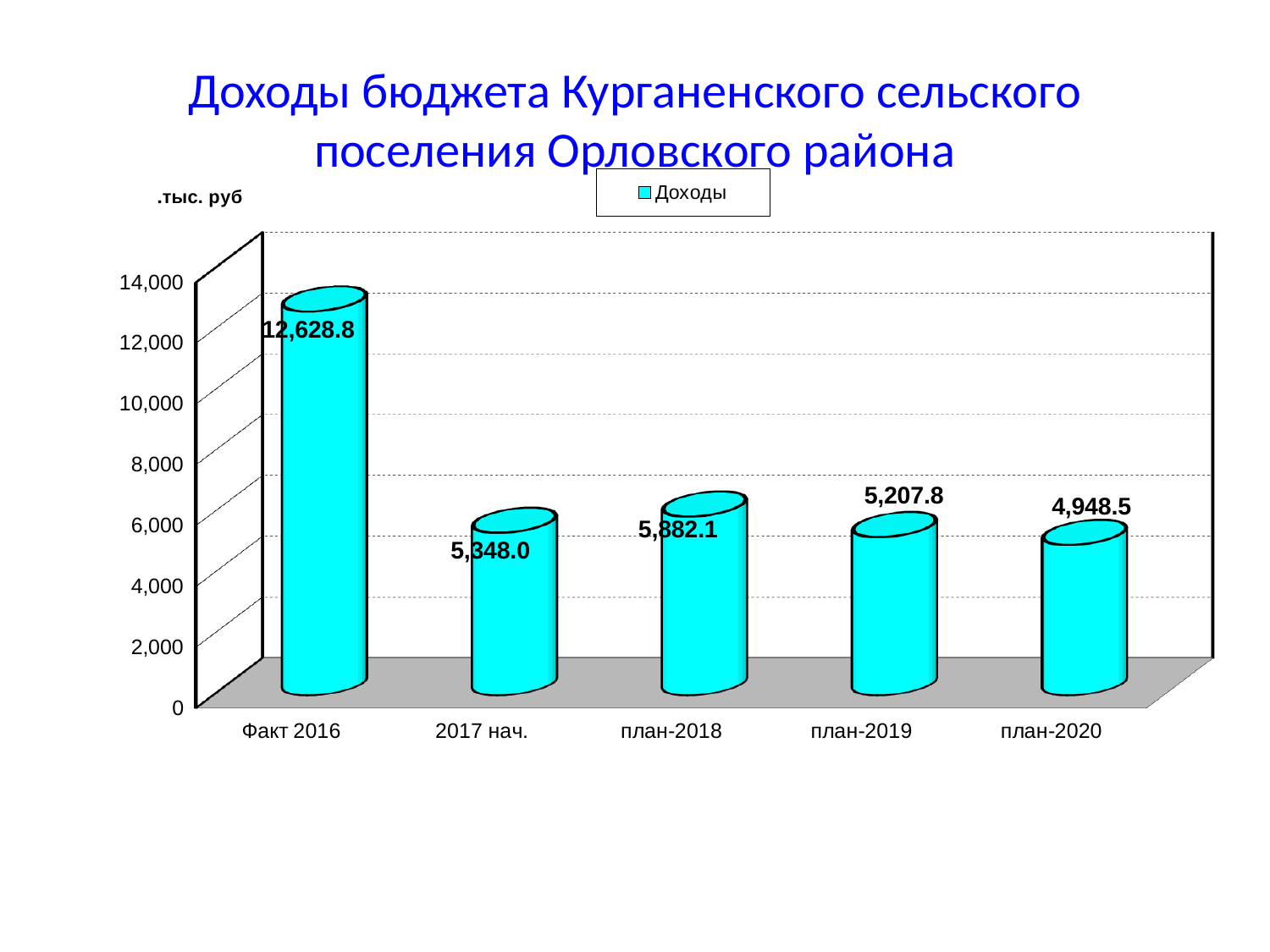
What is the value for план-2019? 5,207.8 How many categories are shown on the x axis? 5 Which category has the highest value? Факт 2016 How many series does the legend list? 1 What is the difference between the values for план-2018 and план-2019? 674.3 Which category has the lowest value? план-2020 What is the value for Факт 2016? 12,628.8 Which is larger, the value for 2017 нач. or the value for план-2018? план-2018 What is the difference between the values for Факт 2016 and 2017 нач.? 7,280.8 What kind of chart is shown on the slide? bar chart Is the value for план-2020 greater or less than 6,000? less What is the value for план-2020? 4,948.5